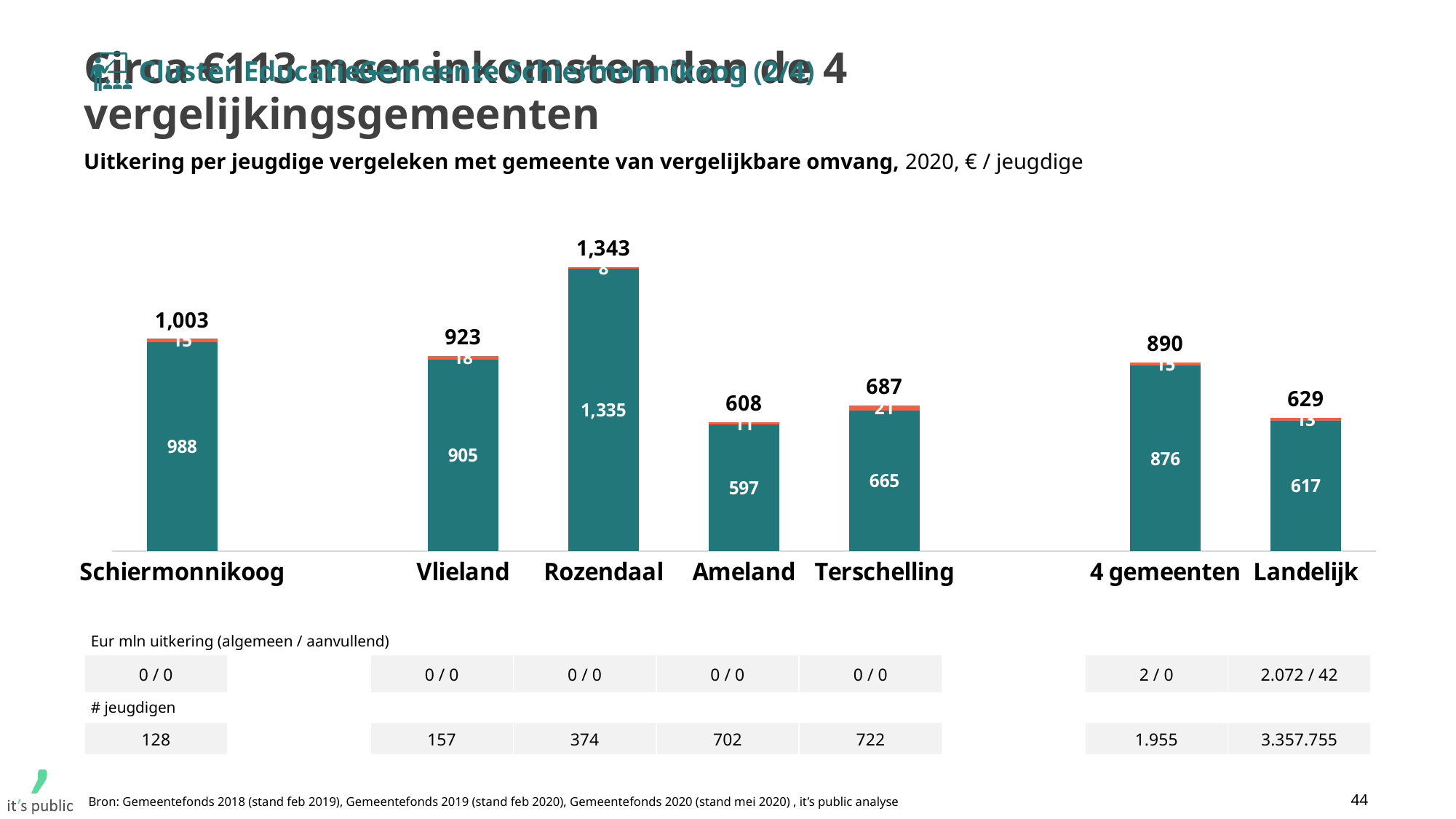
What kind of chart is shown on the slide? Stacked bar chart What is the difference between the total for Schiermonnikoog and the total for 4 gemeenten? 113 What is the value of the large teal segment of the 4 gemeenten bar? 876 What is the value of the large teal segment of the Ameland bar? 597 What is the total value shown above the bar for Landelijk? 629 What is the total value shown above the bar for Rozendaal? 1,343 Which category has the highest total value? Rozendaal What is the difference between the total for Rozendaal and the total for Ameland? 735 What is the value of the large teal segment of the Vlieland bar? 905 Which category has the lowest total value? Ameland Which has a larger total value, Terschelling or Landelijk? Terschelling How many categories are shown on the x axis of the chart? 7